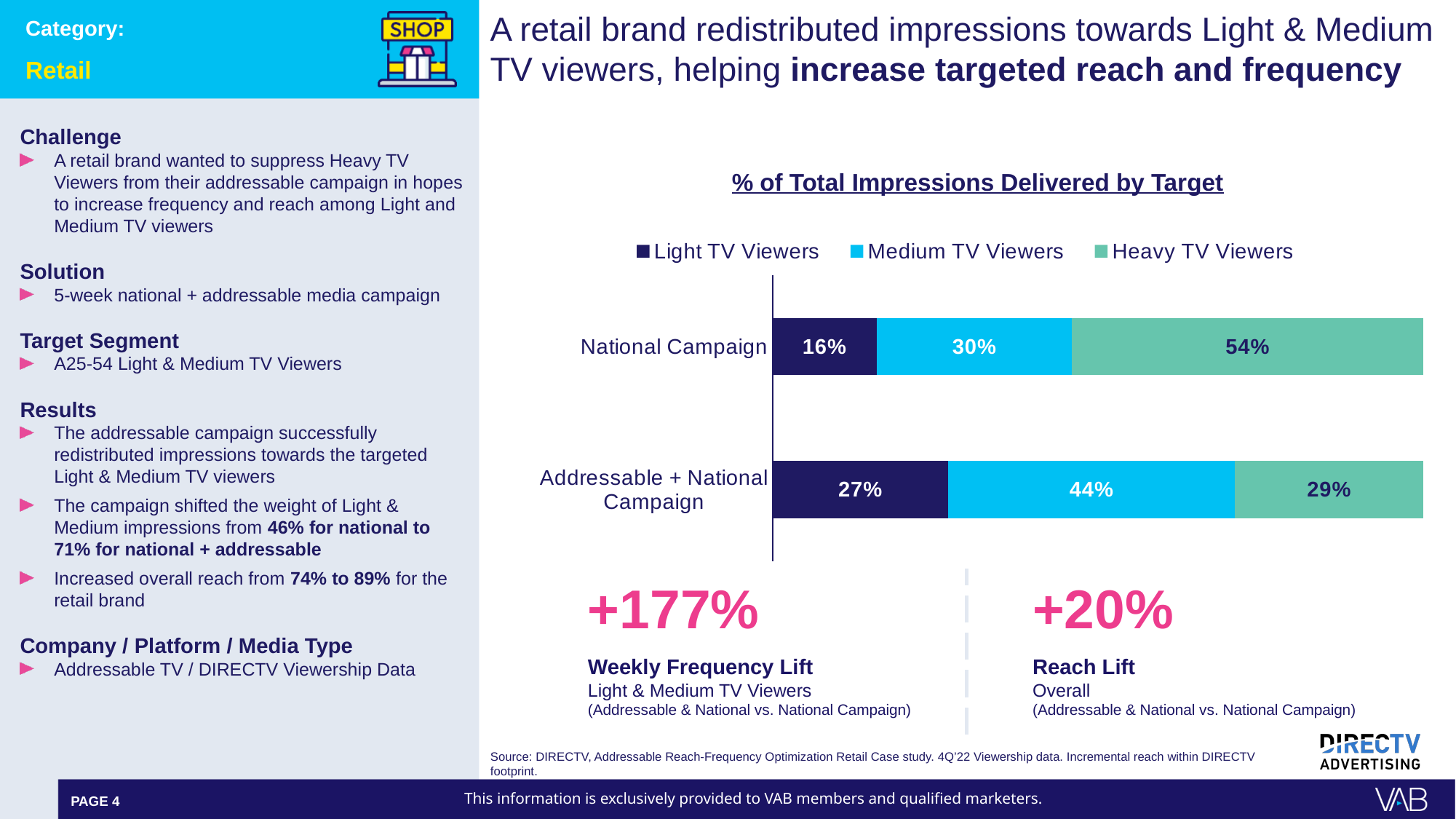
Which viewer segment received the largest share of impressions in the Addressable + National Campaign? Medium TV Viewers Which viewer segment received the smallest share of impressions in the National Campaign? Light TV Viewers What type of chart is used to show the % of Total Impressions Delivered by Target? Stacked bar chart How many campaign categories are shown in the chart? 2 What percentage of total impressions did Light TV Viewers receive in the Addressable + National Campaign? 27% By how many percentage points did the Heavy TV Viewers share fall from the National Campaign to the Addressable + National Campaign? 25 percentage points How many series does the chart legend list? 3 What is the title of the chart? % of Total Impressions Delivered by Target What is the combined share of Light and Medium TV Viewers in the Addressable + National Campaign? 71% What percentage of total impressions did Medium TV Viewers receive in the National Campaign? 30% Which campaign has the larger share of impressions for Medium TV Viewers? Addressable + National Campaign What percentage of total impressions did Heavy TV Viewers receive in the National Campaign? 54%